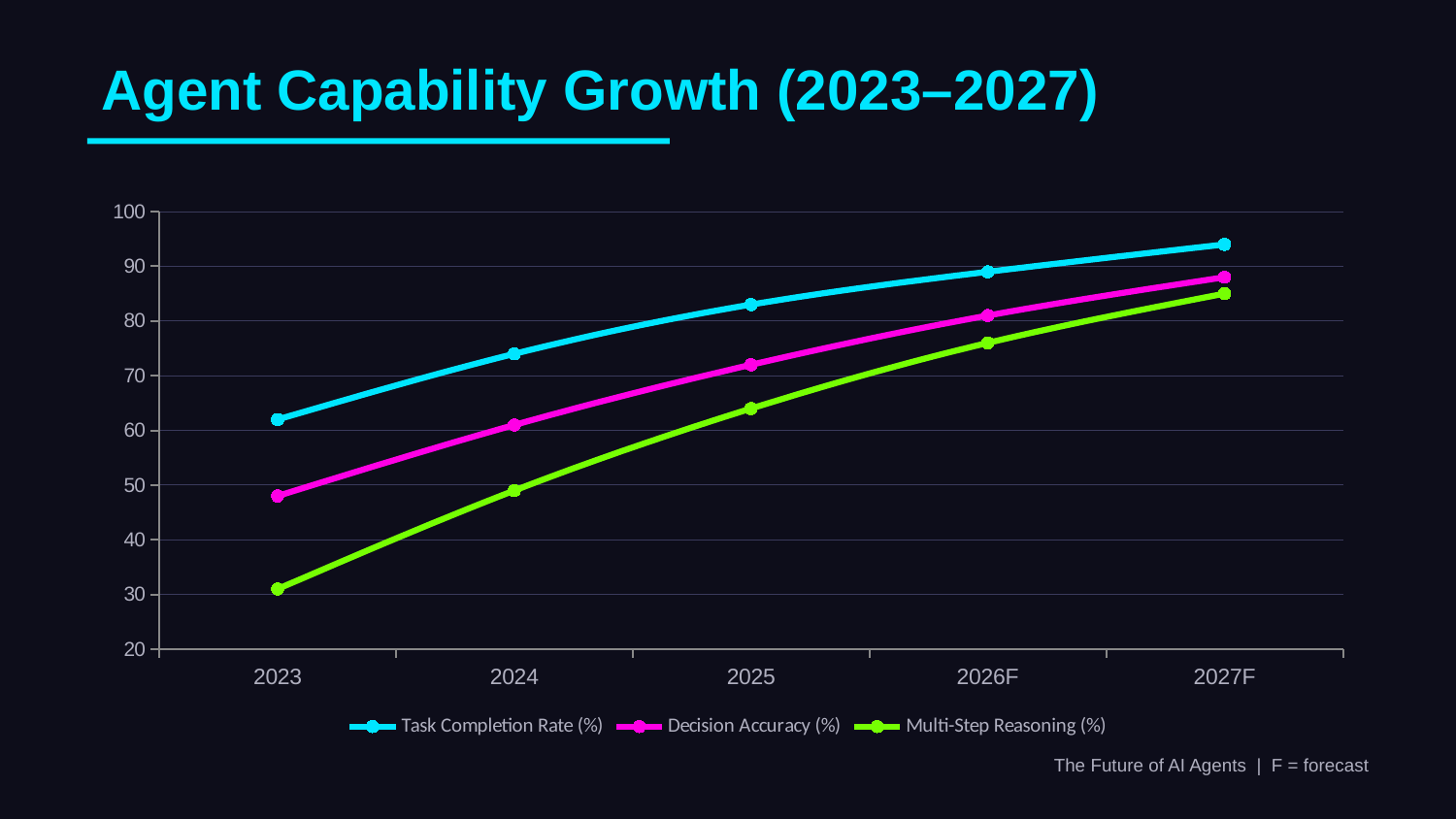
Which series has the lowest value in 2023? Multi-Step Reasoning (%) In 2025, which is larger: Decision Accuracy (%) or Multi-Step Reasoning (%)? Decision Accuracy (%) What kind of chart is shown on the slide? line chart Is the value for Task Completion Rate (%) in 2027F greater or less than 90? greater Does the Multi-Step Reasoning (%) series rise or fall from 2023 to 2027F? rise Is the value for Multi-Step Reasoning (%) in 2023 greater or less than 40? less Is the value for Task Completion Rate (%) in 2025 greater or less than 80? greater What is the title of the chart? Agent Capability Growth (2023–2027) How many years are shown on the x axis? 5 How many series does the legend list? 3 Which series has the highest value in 2023? Task Completion Rate (%)